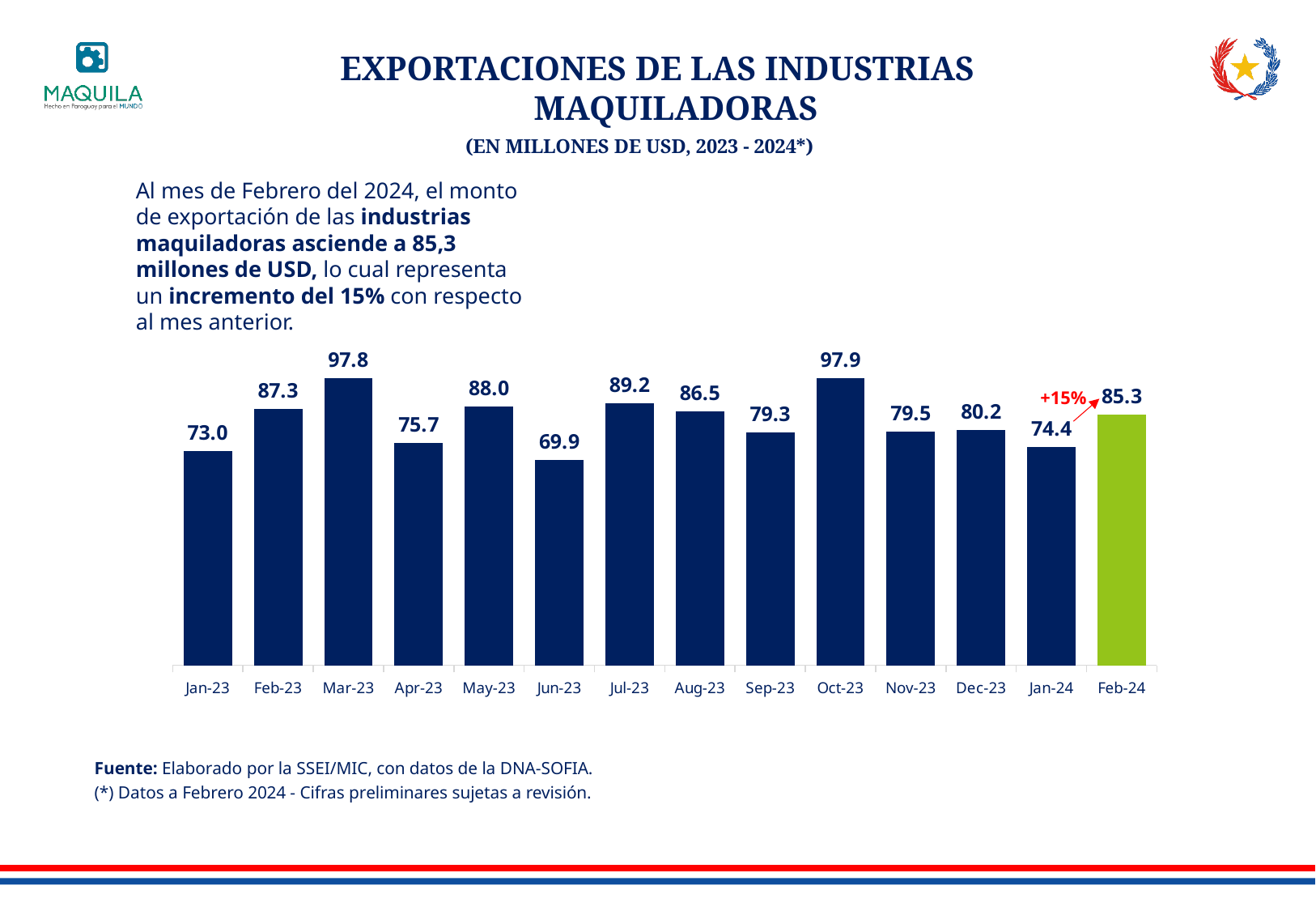
What is the export value for Feb-24? 85.3 What is the export value for Mar-23? 97.8 What kind of chart is shown on the slide? Bar chart How many months are shown on the chart? 14 What is the difference between the export values for Feb-24 and Jan-24? 10.9 Which month has the lowest export value? Jun-23 Which bar is shown in a different colour (green) from the others? Feb-24 Do the export values rise or fall from Jan-23 to Mar-23? Rise Which month has the highest export value? Oct-23 What is the export value for Jun-23? 69.9 Which is larger, the export value for Jul-23 or Aug-23? Jul-23 What percentage change is annotated between Jan-24 and Feb-24? +15%